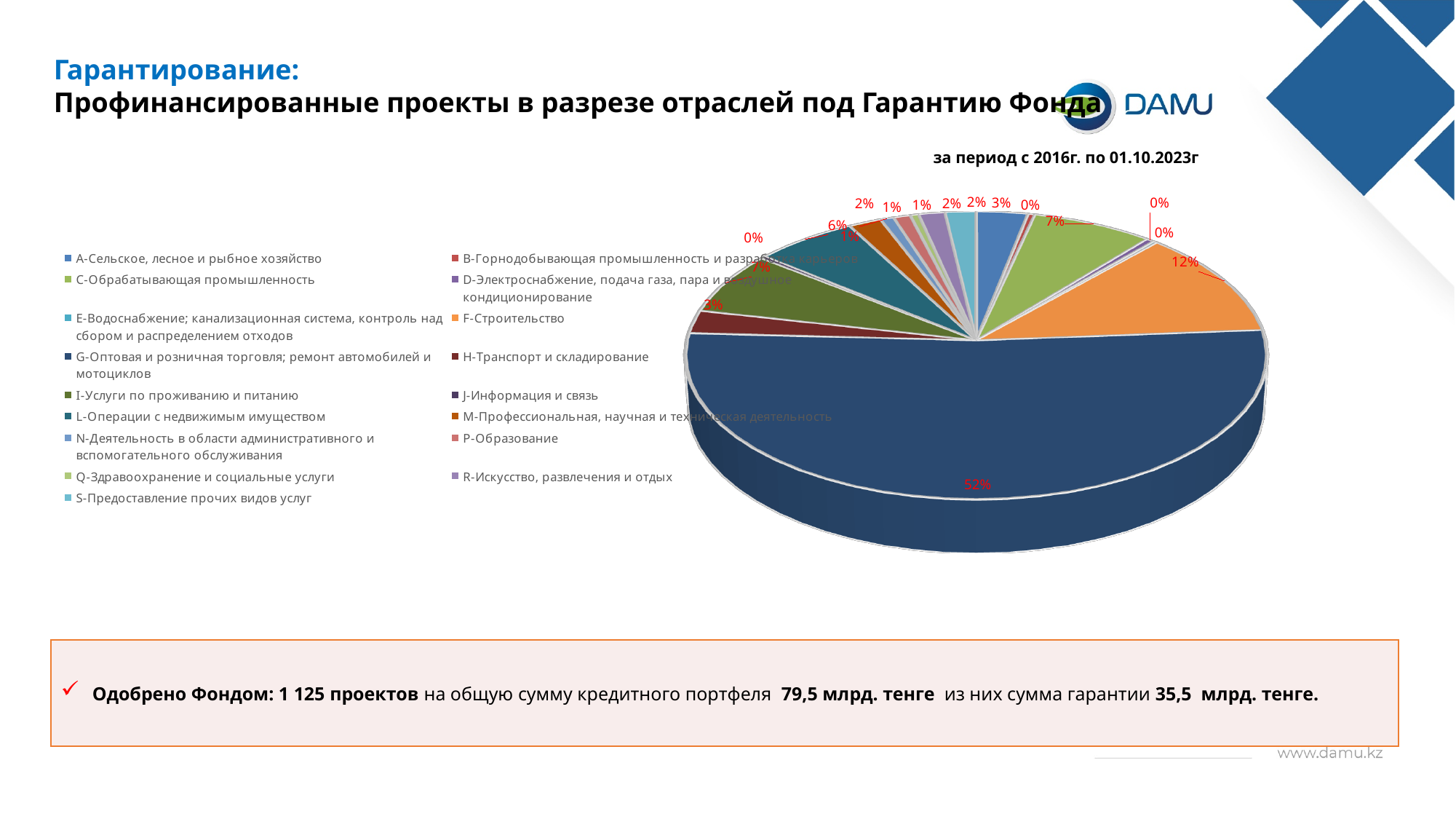
Which industry has the largest share in the pie chart? G-Оптовая и розничная торговля; ремонт автомобилей и мотоциклов How many industry categories are listed in the legend of the pie chart? 17 What is the share of the largest slice in the pie chart? 52% What share does L-Операции с недвижимым имуществом have in the pie chart? 6% What period does the pie chart cover, according to the text above it? за период с 2016г. по 01.10.2023г What share does A-Сельское, лесное и рыбное хозяйство have in the pie chart? 3% What share does F-Строительство have in the pie chart? 12% What is the title of the slide containing the pie chart? Гарантирование: Профинансированные проекты в разрезе отраслей под Гарантию Фонда Which has a larger share: G-Оптовая и розничная торговля or F-Строительство? G-Оптовая и розничная торговля What kind of chart is shown on the slide? Pie chart By how many percentage points does the share of G-Оптовая и розничная торговля exceed that of F-Строительство? 40 percentage points What share does C-Обрабатывающая промышленность have in the pie chart? 7%